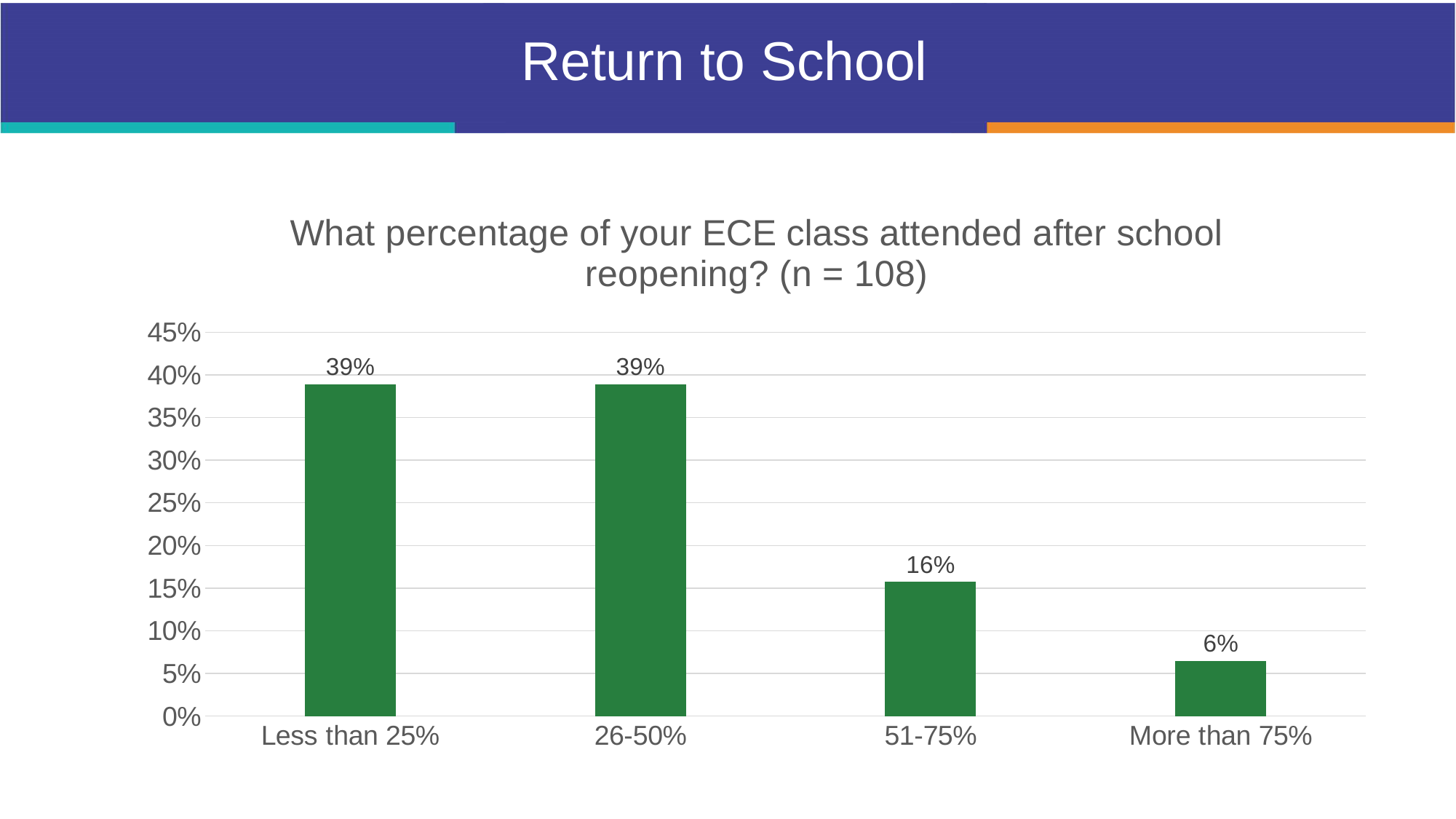
What is the difference between the values for '51-75%' and 'More than 75%'? 10% What is the sample size (n) stated in the chart title? 108 What is the value for the 'Less than 25%' category? 39% What is the value for the '26-50%' category? 39% What is the value for the '51-75%' category? 16% Which category has the lowest value? More than 75% Is the value for '51-75%' greater or less than 20%? less How many categories are shown on the x axis? 4 Which is larger, the value for '51-75%' or the value for 'More than 75%'? 51-75% What kind of chart is shown on the slide? bar chart What is the difference between the values for '26-50%' and '51-75%'? 23% What is the value for the 'More than 75%' category? 6%